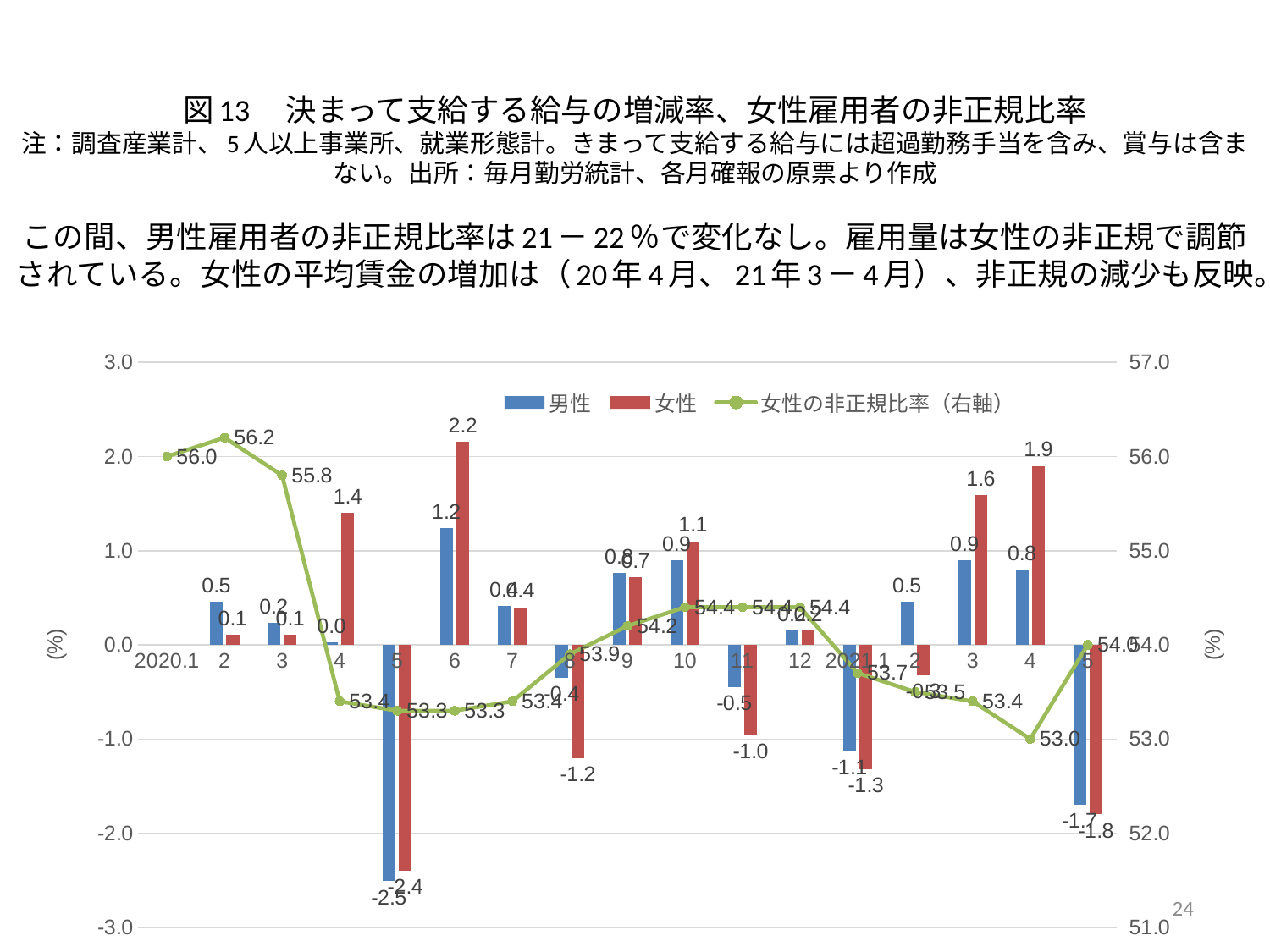
What is the value of the 女性 bar for 2020.6? 2.2 What is the difference between the 女性 and 男性 values for 2021.4? 1.1 What is the label on the right-hand vertical axis? (%) What is the value of the 女性の非正規比率（右軸） line at 2020.2? 56.2 For 2021.3, which is larger, the 男性 value or the 女性 value? 女性 In which month is the 女性 bar highest? 2020.6 In which month is the 男性 bar lowest? 2020.5 What is the value of the 女性 bar for 2020.8? -1.2 What is the value of the 男性 bar for 2021.1? -1.1 At which month does the 女性の非正規比率（右軸） line reach its lowest value? 2021.4 What kind of chart is shown on the slide? A combined bar and line chart How many series does the legend list? 3